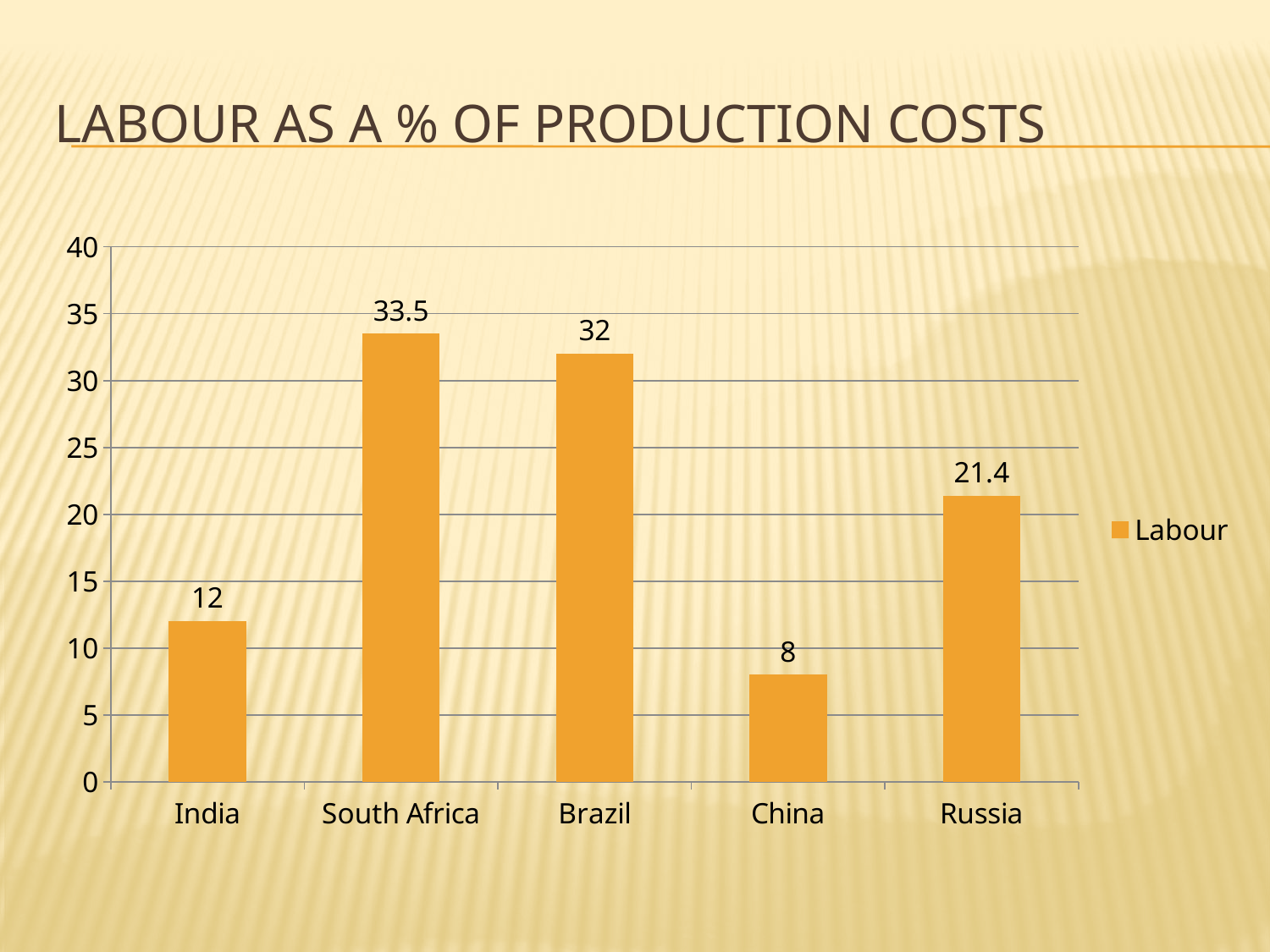
What is the value for Russia? 21.4 How many countries are shown on the chart? 5 Is the value for Brazil greater or less than 30? greater What is the value for South Africa? 33.5 Which country has the lowest value? China Which country has the highest value? South Africa What kind of chart is shown on the slide? bar chart Which is larger, the value for Russia or the value for India? Russia What series name does the legend show? Labour What is the difference between the values for South Africa and Brazil? 1.5 What is the difference between the values for India and China? 4 What is the value for China? 8